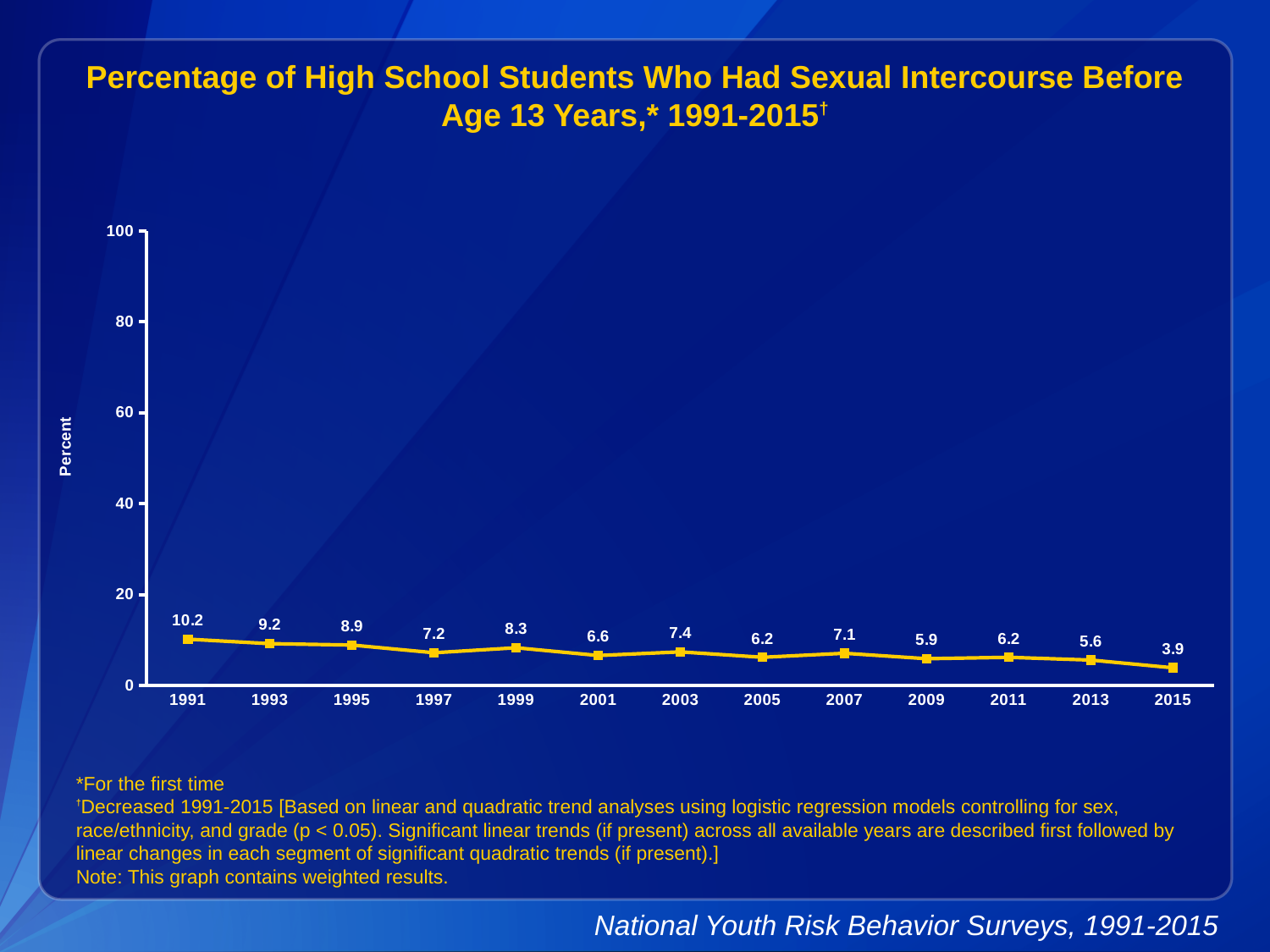
Which year has the highest value? 1991 What is the value for 2003? 7.4 Which year has the lowest value? 2015 What is the value for 1991? 10.2 What is the difference between the values for 1991 and 2015? 6.3 Which is larger, the value for 1999 or the value for 2001? 1999 What is the value for 2015? 3.9 Is the value for 1991 greater or less than 20? less What is the label on the y axis? Percent How many years are plotted on the chart? 13 Do the values generally rise or fall from 1991 to 2015? fall What kind of chart is shown? line chart